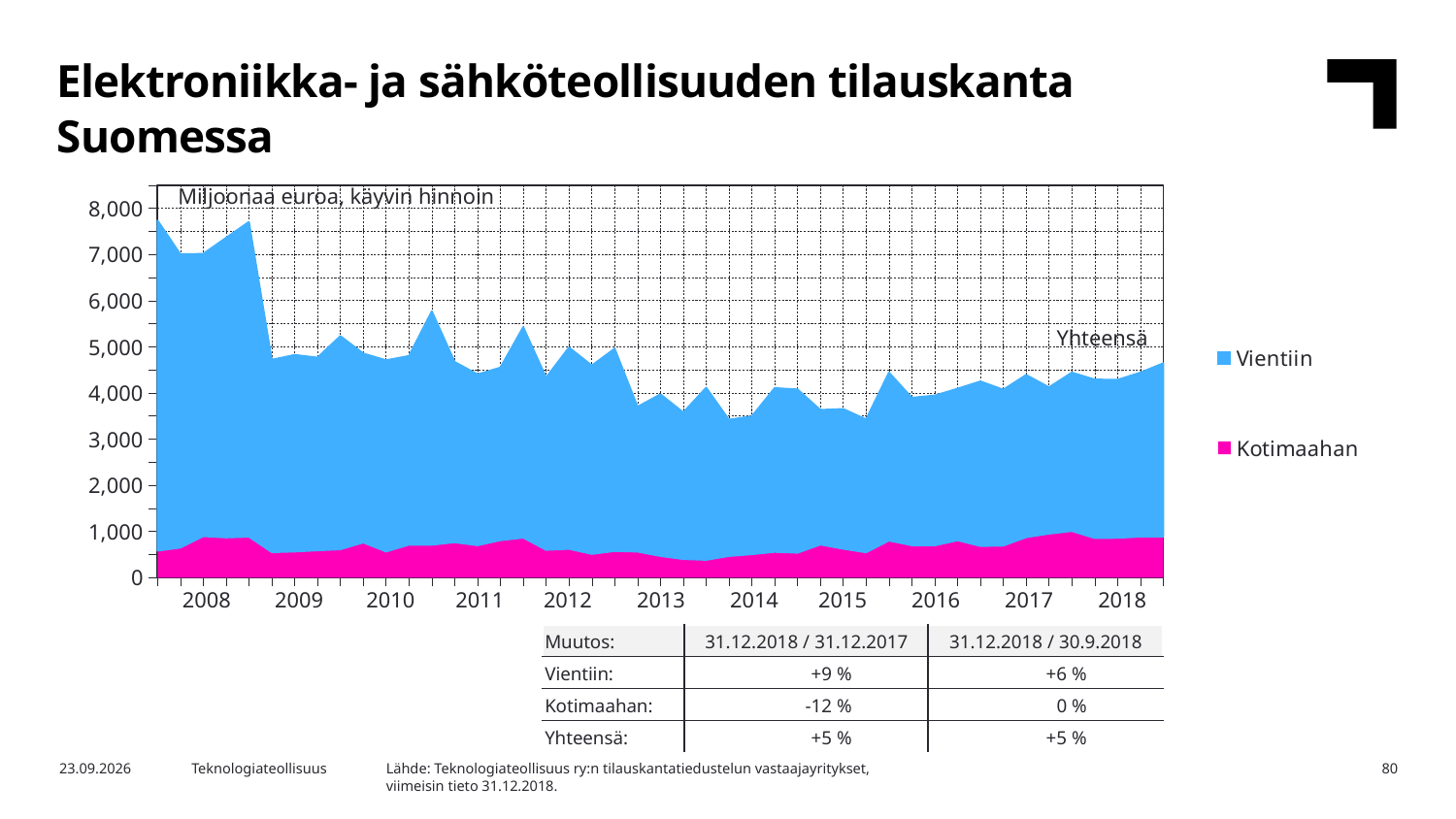
According to the table below the chart, what is the change in Kotimaahan between 31.12.2017 and 31.12.2018? -12 % How many series does the chart legend list? 2 Does the total order stock rise or fall overall from 2008 to 2018? fall What are the two series named in the chart legend? Vientiin and Kotimaahan In which year is the total order stock (Yhteensä) highest? 2008 Is the total order stock (Yhteensä) at the end of 2018 greater or less than 5,000? less Which series is larger throughout the chart, Vientiin or Kotimaahan? Vientiin What unit label is printed at the top of the chart area? Miljoonaa euroa, käyvin hinnoin Is the total order stock (Yhteensä) at the start of 2008 greater or less than 7,000? greater What kind of chart is shown on the slide? Stacked area chart How many years are labelled on the x axis of the chart? 11 Is the Kotimaahan value in 2014 greater or less than 1,000? less